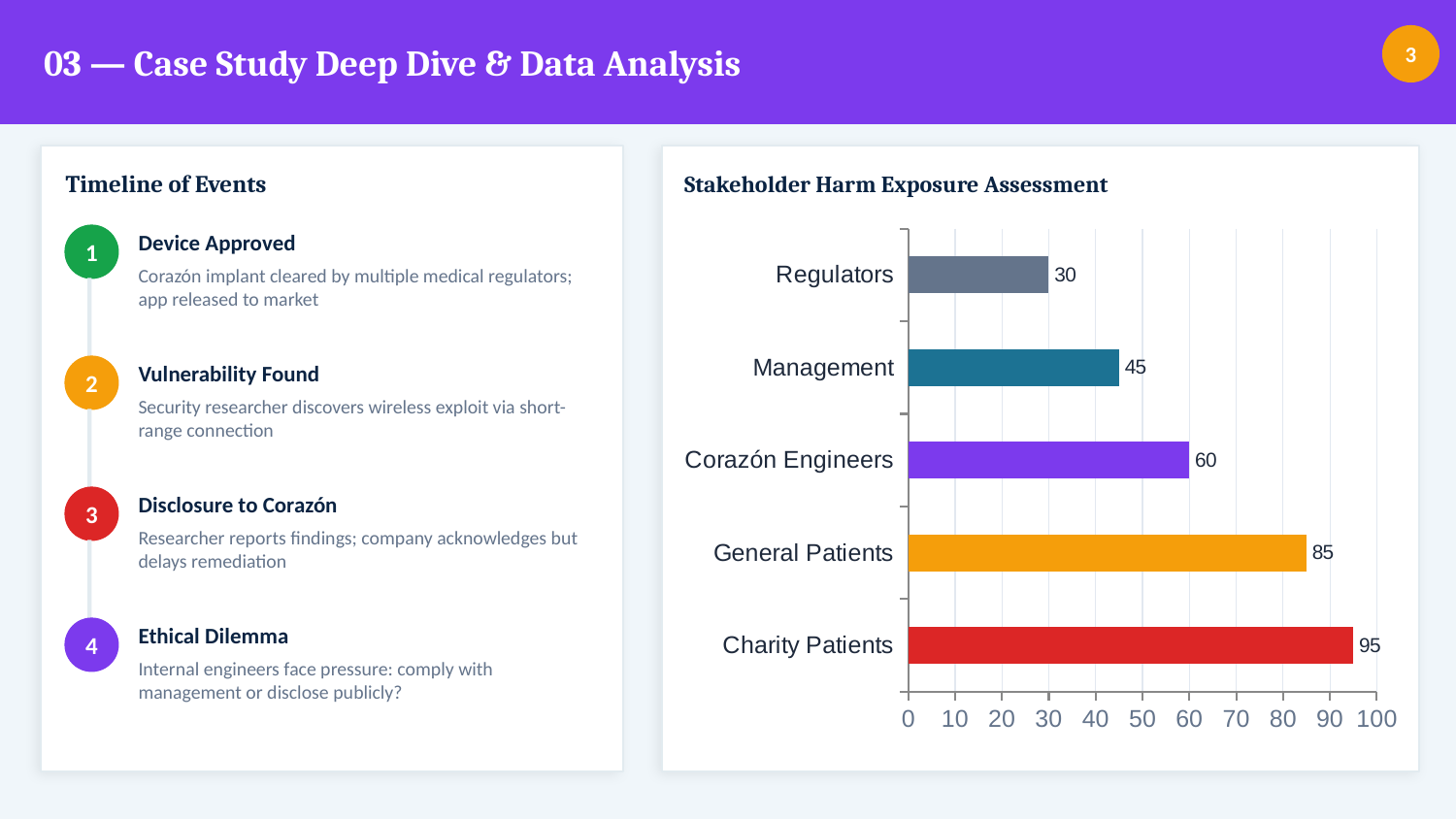
Which category has the highest value in the Stakeholder Harm Exposure Assessment chart? Charity Patients How many categories are shown in the Stakeholder Harm Exposure Assessment chart? 5 What is the difference between the values for General Patients and Management in the Stakeholder Harm Exposure Assessment chart? 40 Is the value for General Patients in the Stakeholder Harm Exposure Assessment chart greater or less than 80? greater What kind of chart is the Stakeholder Harm Exposure Assessment? Bar chart Which category has the lowest value in the Stakeholder Harm Exposure Assessment chart? Regulators What is the maximum value shown on the horizontal axis of the Stakeholder Harm Exposure Assessment chart? 100 Which is larger in the Stakeholder Harm Exposure Assessment chart, the value for Management or the value for Corazón Engineers? Corazón Engineers What is the title of the chart on the right side of the slide? Stakeholder Harm Exposure Assessment What is the value for Charity Patients in the Stakeholder Harm Exposure Assessment chart? 95 What is the value for Corazón Engineers in the Stakeholder Harm Exposure Assessment chart? 60 What is the value for Regulators in the Stakeholder Harm Exposure Assessment chart? 30